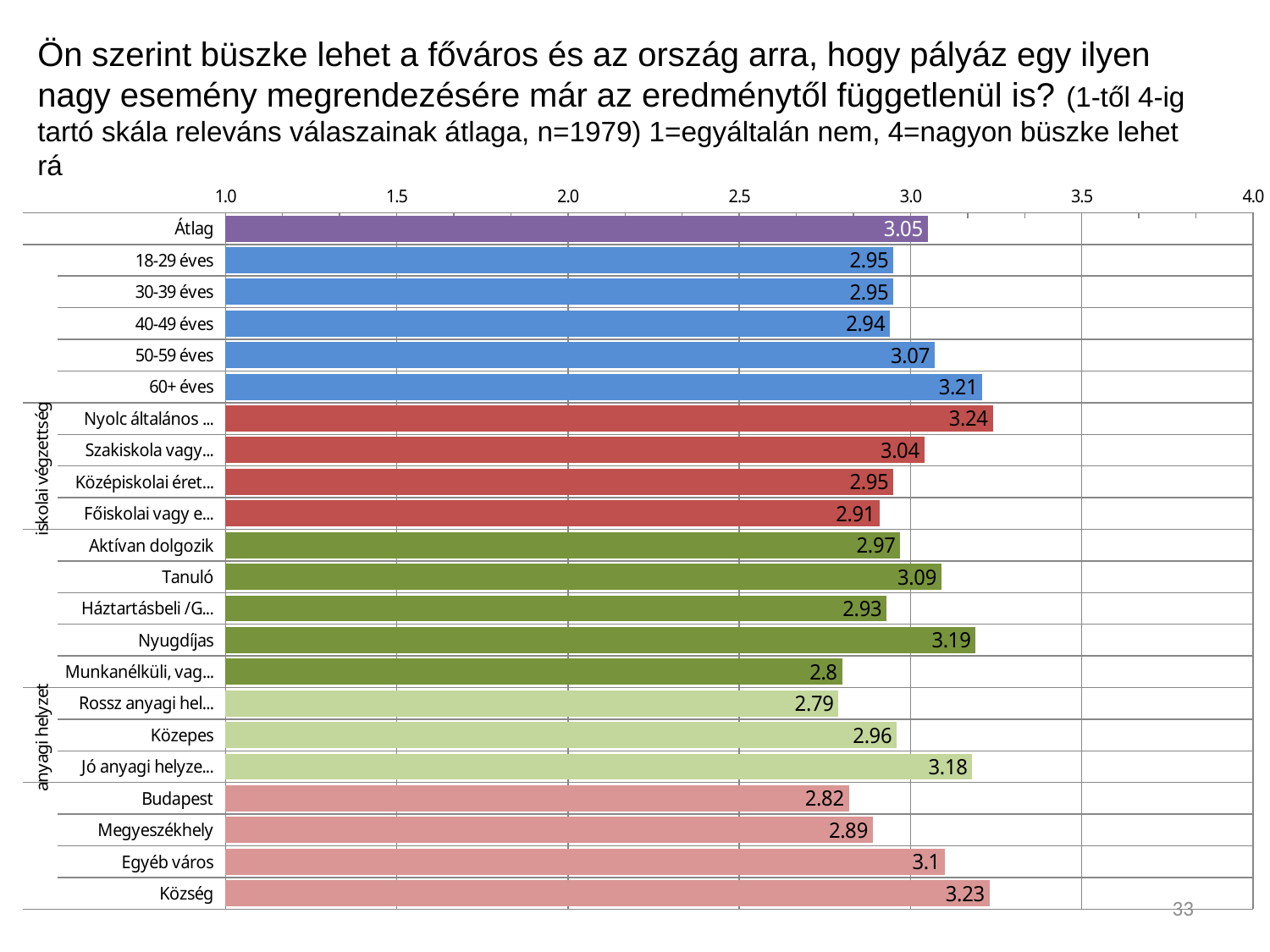
How many bars are shown in the chart? 22 Among the age groups (18-29 éves to 60+ éves), which has the highest value? 60+ éves What is the value for 60+ éves? 3.21 What is the value for Budapest? 2.82 What is the value for Nyugdíjas? 3.19 Is the value for Megyeszékhely greater or less than 3.0? less What is the difference between the values for Község and Budapest? 0.41 Which is larger, the value for Tanuló or the value for Aktívan dolgozik? Tanuló What is the value for Átlag? 3.05 What is the value for Község? 3.23 What kind of chart is shown on the slide? bar chart Among Budapest, Megyeszékhely, Egyéb város and Község, which has the lowest value? Budapest